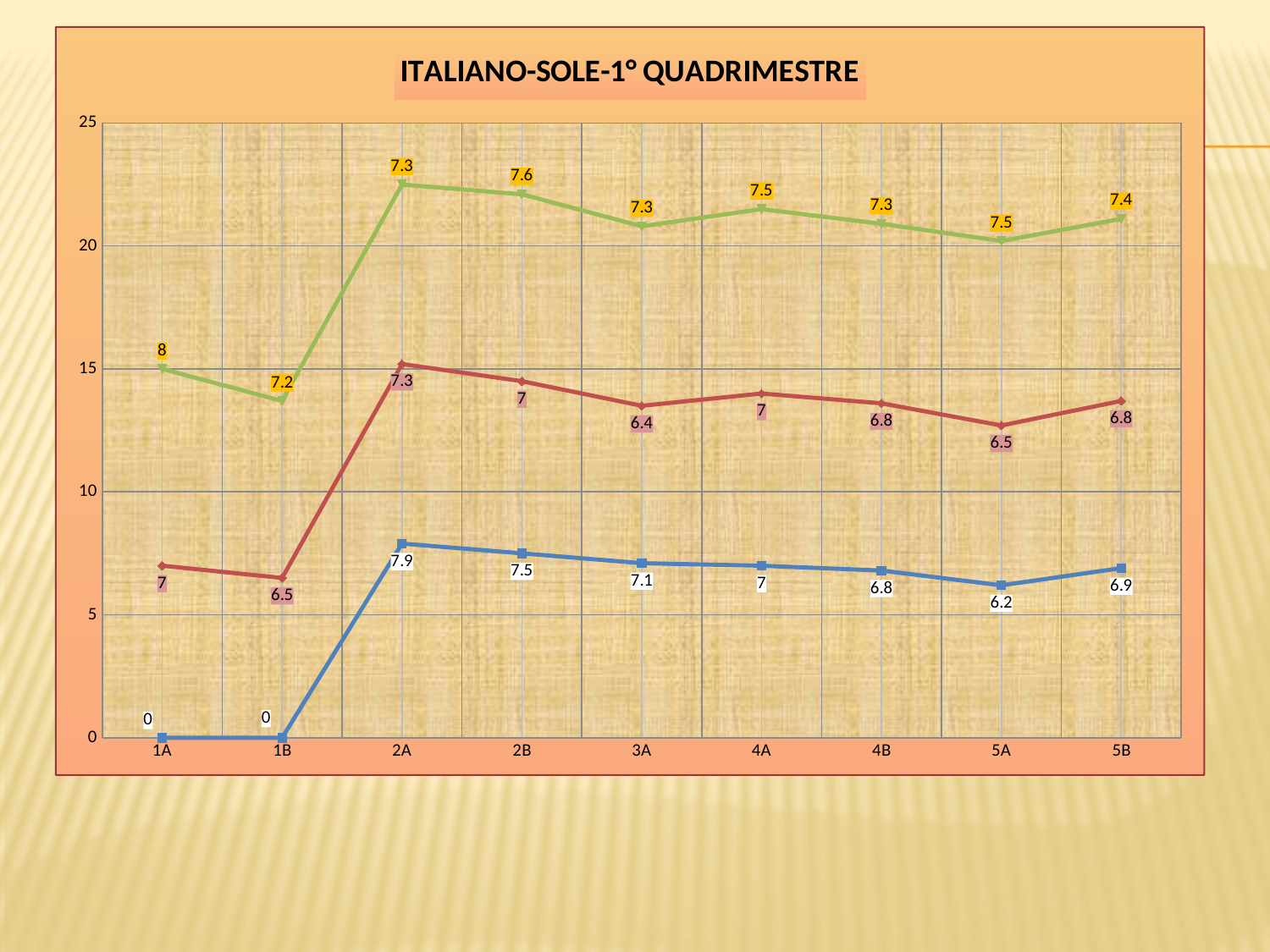
What is the labelled value of the blue line at 1B? 0 Do the blue line's labelled values rise or fall from 2A to 5A? fall How many categories are shown on the x axis? 9 At 2B, which has the larger labelled value, the green line or the red line? green line What is the labelled value of the blue line at 2A? 7.9 What is the labelled value of the red line at 3A? 6.4 What kind of chart is shown on the slide? line chart What is the difference between the blue line's labelled values at 2A and 5A? 1.7 At which category does the green line have its highest labelled value? 1A At which category does the blue line have its highest labelled value? 2A What is the labelled value of the green line at 2B? 7.6 What is the title of the chart? ITALIANO-SOLE-1° QUADRIMESTRE